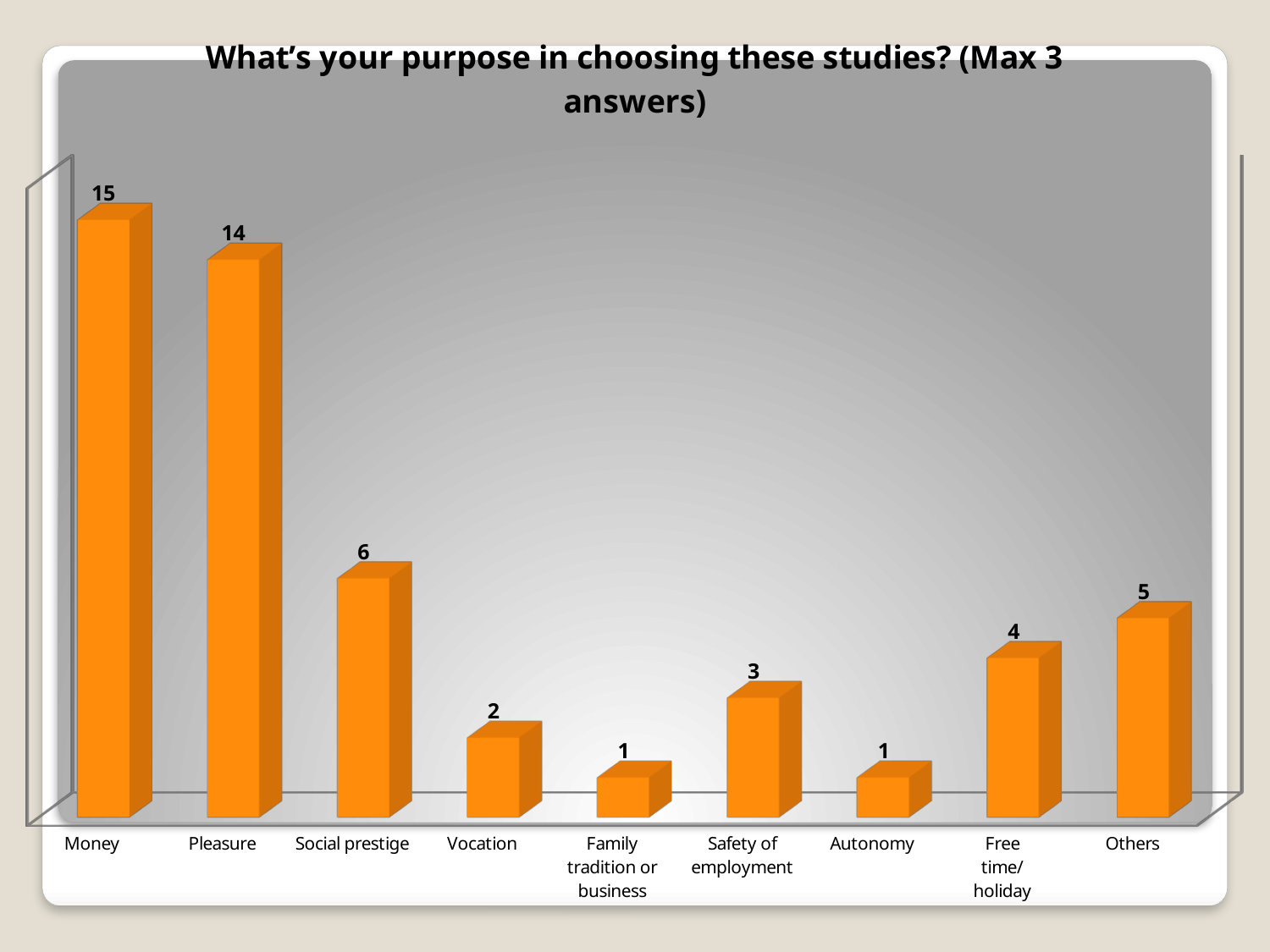
What is the title of the chart? What's your purpose in choosing these studies? (Max 3 answers) What is the value for Safety of employment? 3 Which category has the highest value? Money What is the value for Money? 15 How many categories are shown on the x axis? 9 What is the value for Others? 5 What is the value for Social prestige? 6 What is the difference between the values for Social prestige and Vocation? 4 What is the difference between the values for Money and Pleasure? 1 Which is larger, the value for Free time/holiday or the value for Safety of employment? Free time/holiday What kind of chart is this? Bar chart Which categories share the lowest value? Family tradition or business and Autonomy